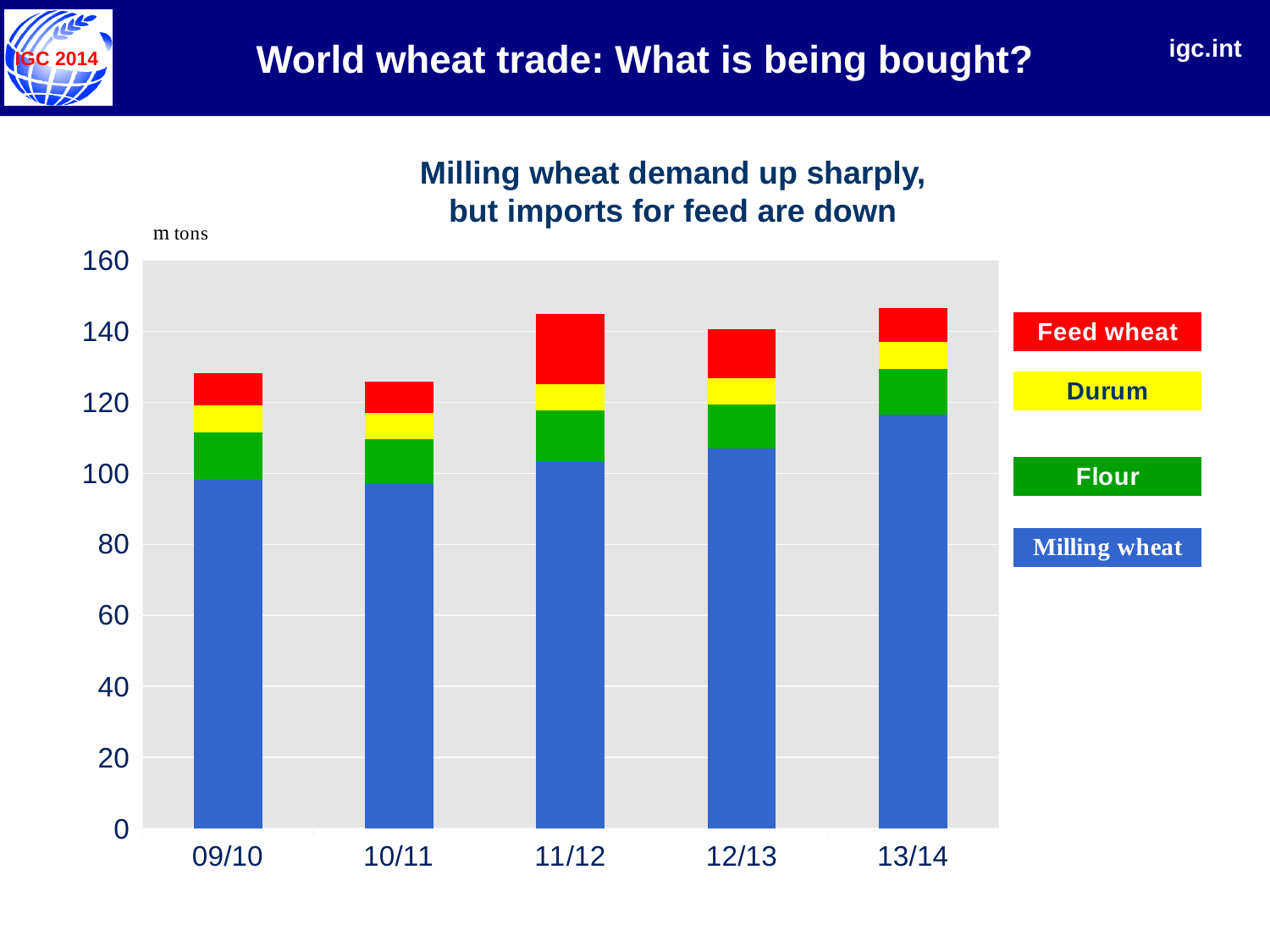
Is the total bar height for 11/12 greater or less than 140? greater What unit is shown above the y axis of the chart? m tons Does the Milling wheat segment rise or fall from 10/11 to 13/14? rise How many series does the chart's legend list? 4 How many seasons are shown on the x axis of the chart? 5 What kind of chart is shown on the slide? Stacked bar chart Is the total bar height for 09/10 greater or less than 120? greater Is the Milling wheat value for 13/14 greater or less than 100? greater Which season has the larger Feed wheat segment, 11/12 or 13/14? 11/12 Which season has the largest Milling wheat segment? 13/14 Which season has the larger total bar, 10/11 or 11/12? 11/12